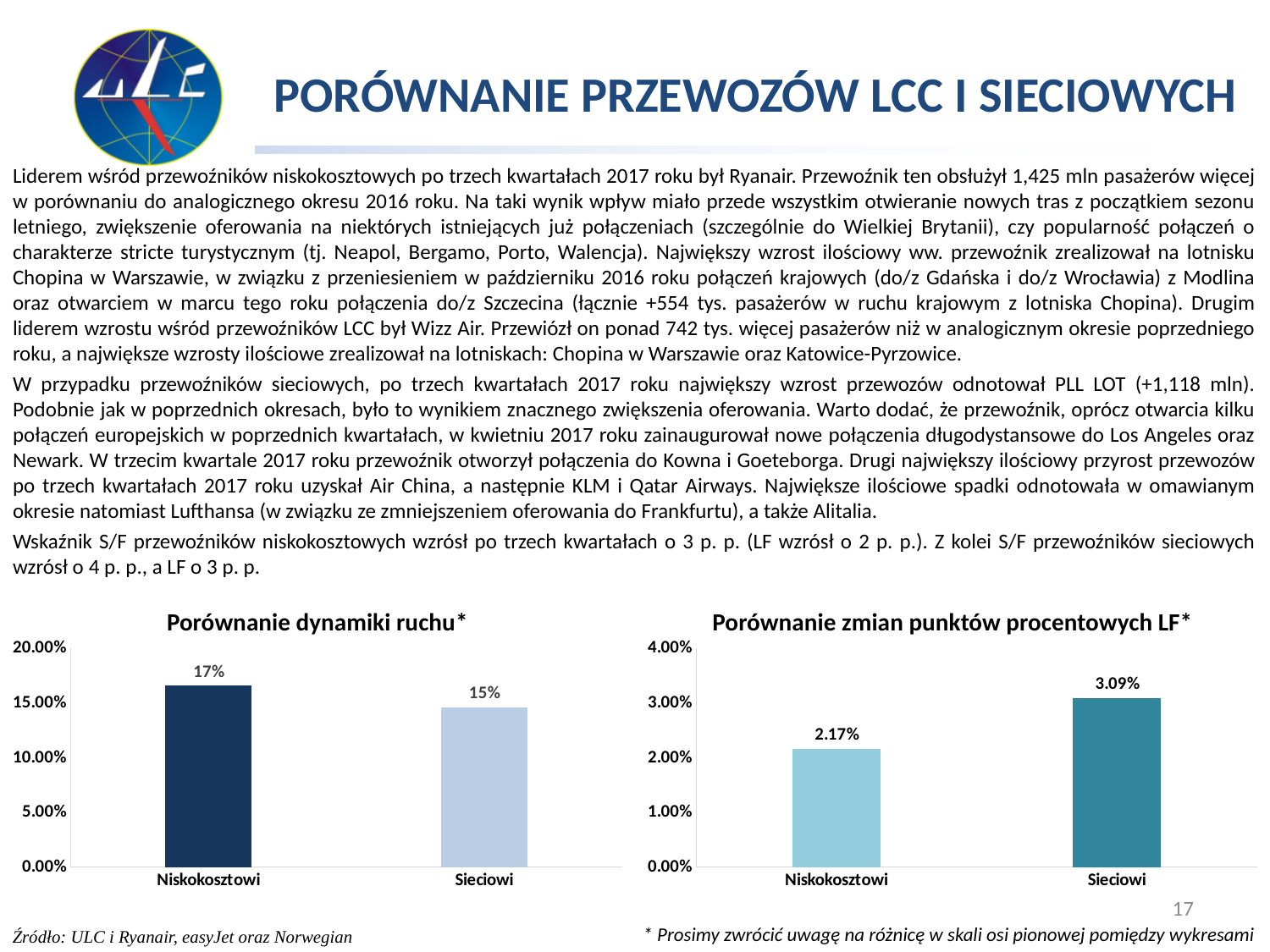
In the chart 'Porównanie zmian punktów procentowych LF*', what is the value for Niskokosztowi? 2.17% In the chart 'Porównanie dynamiki ruchu*', what is the value for Sieciowi? 15% In the chart 'Porównanie dynamiki ruchu*', what is the value for Niskokosztowi? 17% In the chart 'Porównanie zmian punktów procentowych LF*', which is larger: the value for Sieciowi or for Niskokosztowi? Sieciowi In the chart 'Porównanie zmian punktów procentowych LF*', which category has the lowest value? Niskokosztowi In the chart 'Porównanie zmian punktów procentowych LF*', what is the difference between the values for Sieciowi and Niskokosztowi? 0.92% In the chart 'Porównanie dynamiki ruchu*', which category has the highest value? Niskokosztowi In the chart 'Porównanie dynamiki ruchu*', what is the difference between the values for Niskokosztowi and Sieciowi? 2% What kind of chart is 'Porównanie dynamiki ruchu*'? Bar chart In the chart 'Porównanie dynamiki ruchu*', is the value for Sieciowi greater or less than 10.00%? greater How many categories are shown in the chart 'Porównanie zmian punktów procentowych LF*'? 2 In the chart 'Porównanie zmian punktów procentowych LF*', what is the value for Sieciowi? 3.09%